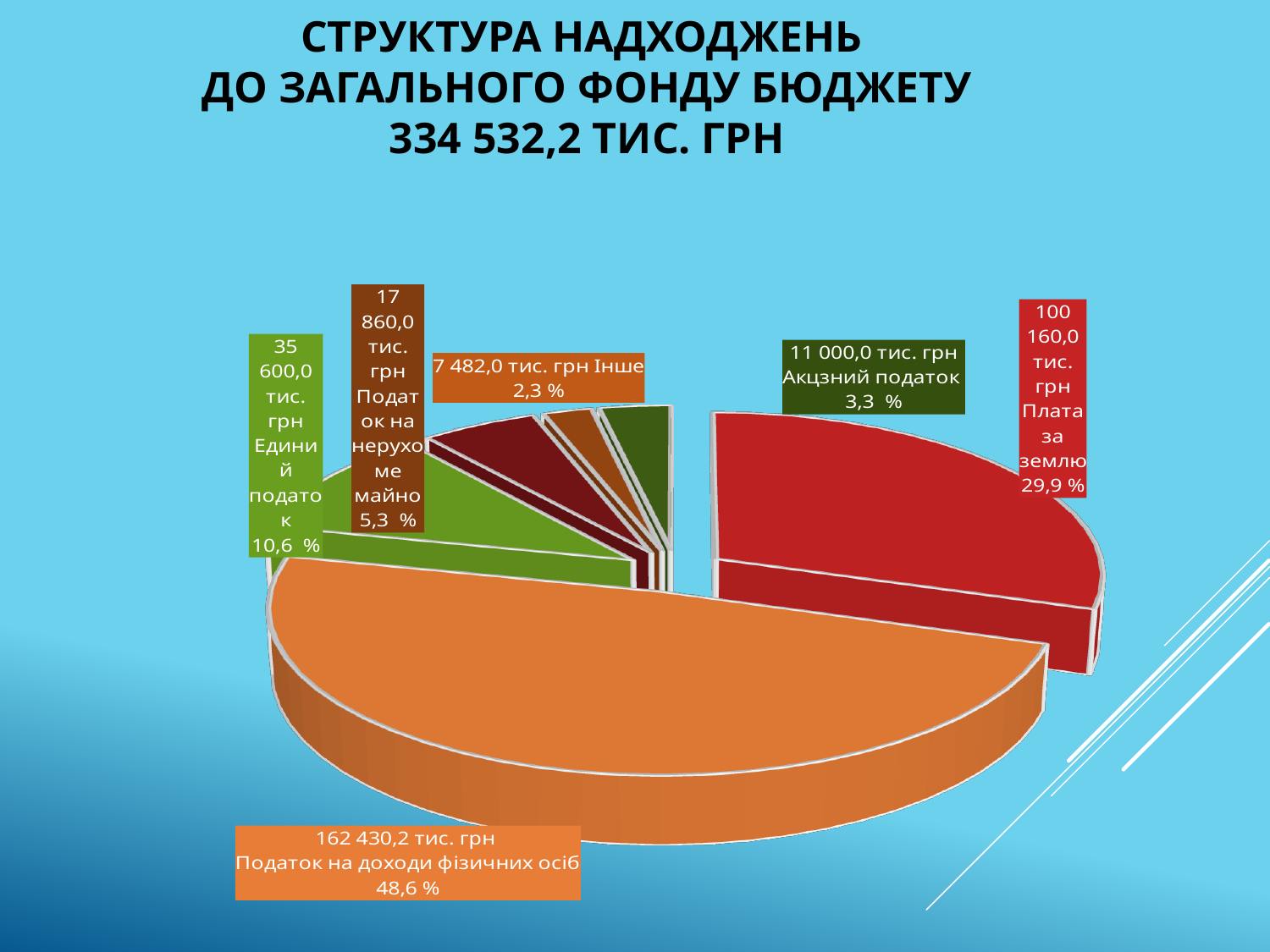
What total amount is stated in the chart title? 334 532,2 тис. грн What is the value for Податок на доходи фізичних осіб? 162 430,2 тис. грн What kind of chart is shown on the slide? pie chart Which labelled category has the smallest share of the pie? Інше What share of the pie does Інше represent? 2,3 % What share of the pie does Плата за землю represent? 29,9 % What share of the pie does Податок на нерухоме майно represent? 5,3 % Which is larger, the value for Плата за землю or the value for Единий податок? Плата за землю What is the value for Акцизний податок? 11 000,0 тис. грн What is the difference in percentage share between Податок на доходи фізичних осіб and Плата за землю? 18,7 % Which category has the largest share of the pie? Податок на доходи фізичних осіб What is the value for Единий податок? 35 600,0 тис. грн